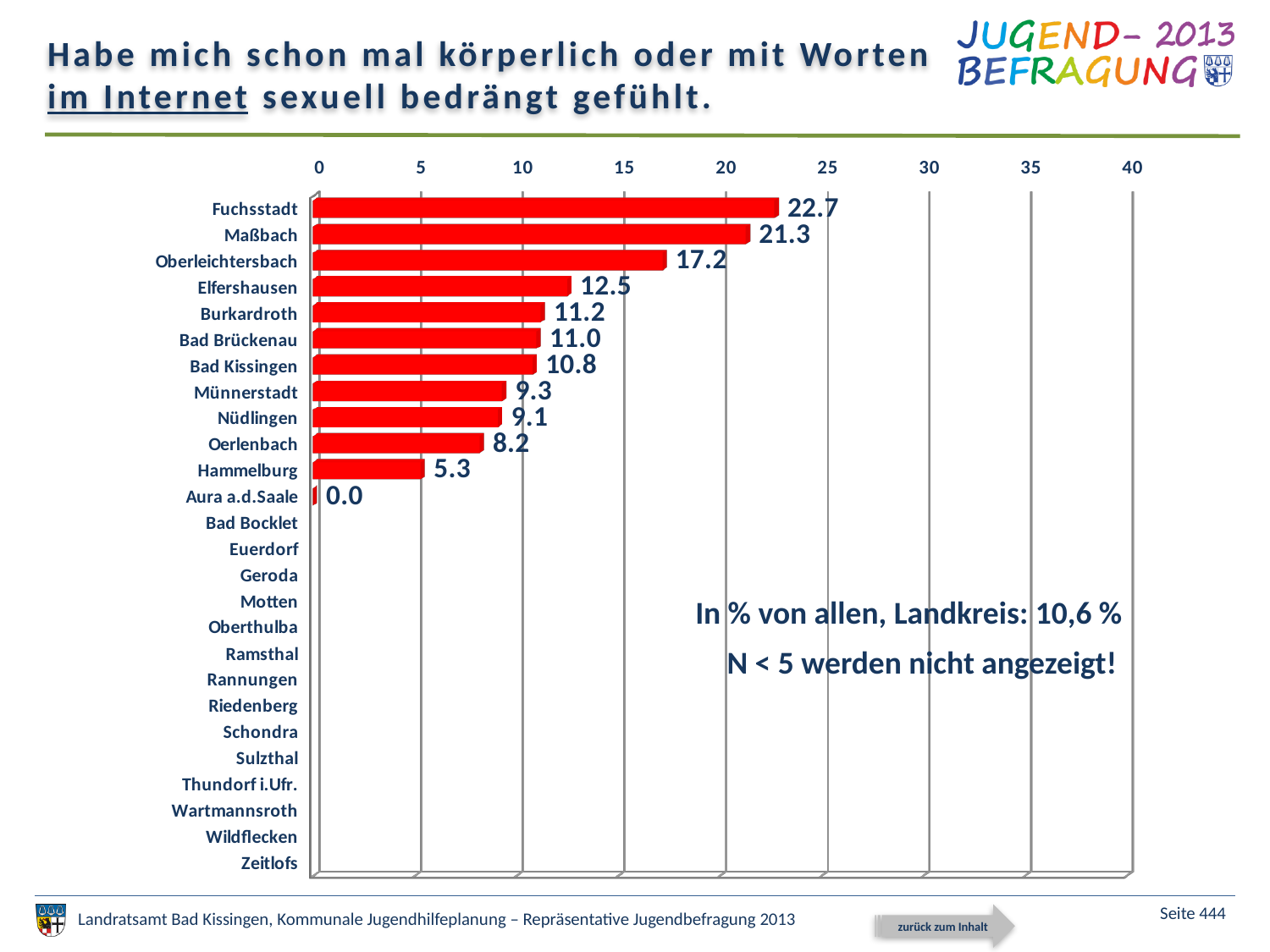
What type of chart is shown on the slide? bar chart Which municipality has the highest value in the chart? Fuchsstadt What is the difference between the values for Oberleichtersbach and Elfershausen? 4.7 How many municipalities have a value displayed as a bar in the chart? 12 What is the value shown for Hammelburg? 5.3 Which municipality with a displayed bar has the lowest value? Aura a.d.Saale Which has a larger value, Münnerstadt or Oerlenbach? Münnerstadt According to the note on the chart, what is the percentage for the Landkreis overall? 10,6 % What is the difference between the values for Fuchsstadt and Maßbach? 1.4 Is the value for Oberleichtersbach greater or less than 15? greater What is the value shown for Fuchsstadt? 22.7 What is the value shown for Bad Kissingen? 10.8